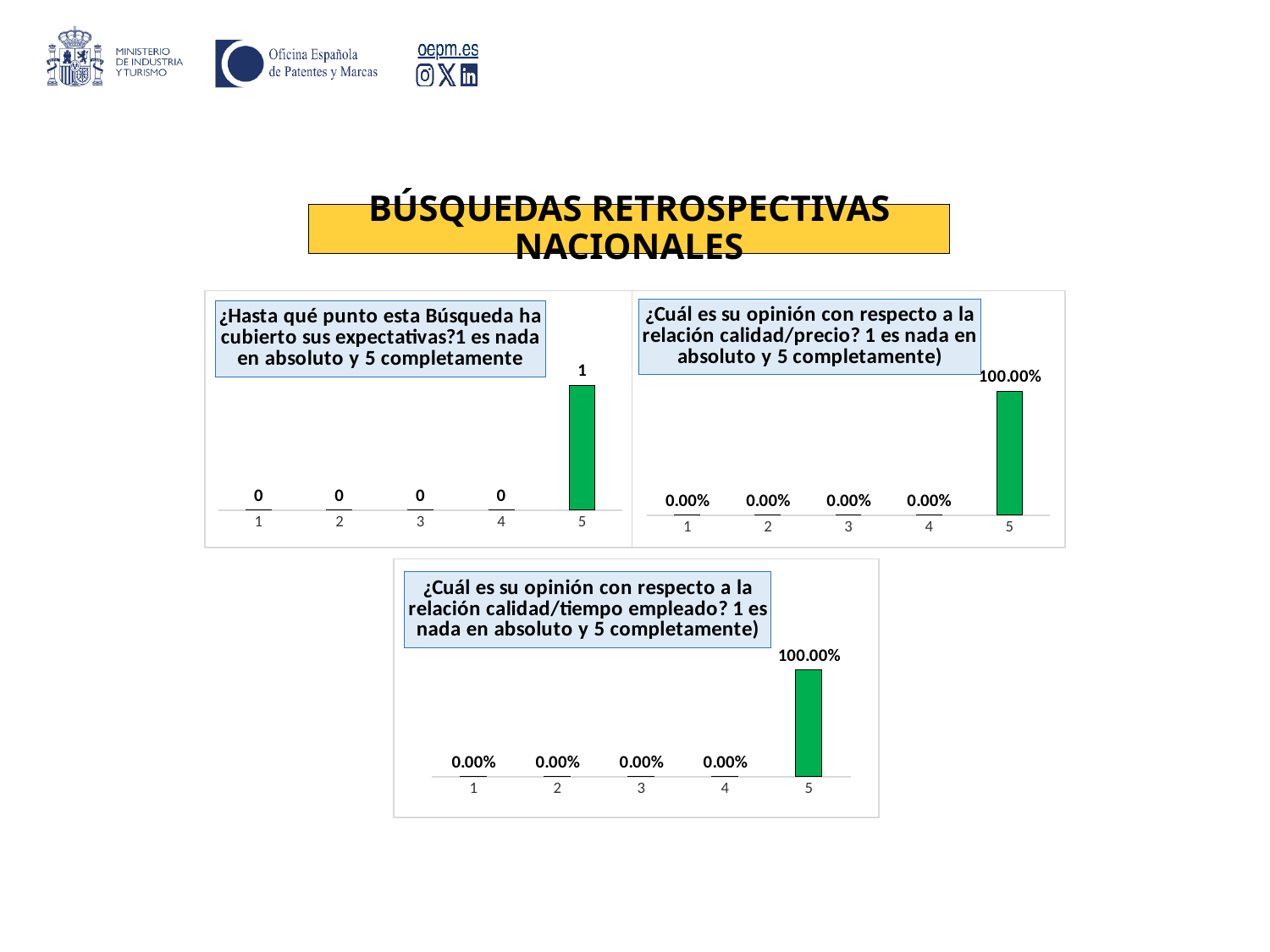
In the bottom chart (relación calidad/tiempo empleado), which category has the highest value? 5 In the top-left chart (¿Hasta qué punto esta Búsqueda ha cubierto sus expectativas?), what is the value for category 3? 0 In the top-right chart (relación calidad/precio), what is the difference between the values for category 5 and category 1? 100.00% In the bottom chart (relación calidad/tiempo empleado), how many categories are shown on the x axis? 5 In the bottom chart (relación calidad/tiempo empleado), what is the value for category 5? 100.00% In the top-left chart (¿Hasta qué punto esta Búsqueda ha cubierto sus expectativas?), what is the value for category 5? 1 What kind of chart is the top-right chart (relación calidad/precio)? bar chart How many charts are shown on the slide? 3 In the top-right chart (relación calidad/precio), what is the value for category 5? 100.00% In the top-left chart (¿Hasta qué punto esta Búsqueda ha cubierto sus expectativas?), which category has the highest value? 5 In the bottom chart (relación calidad/tiempo empleado), what is the value for category 4? 0.00% In the top-right chart (relación calidad/precio), what is the value for category 2? 0.00%